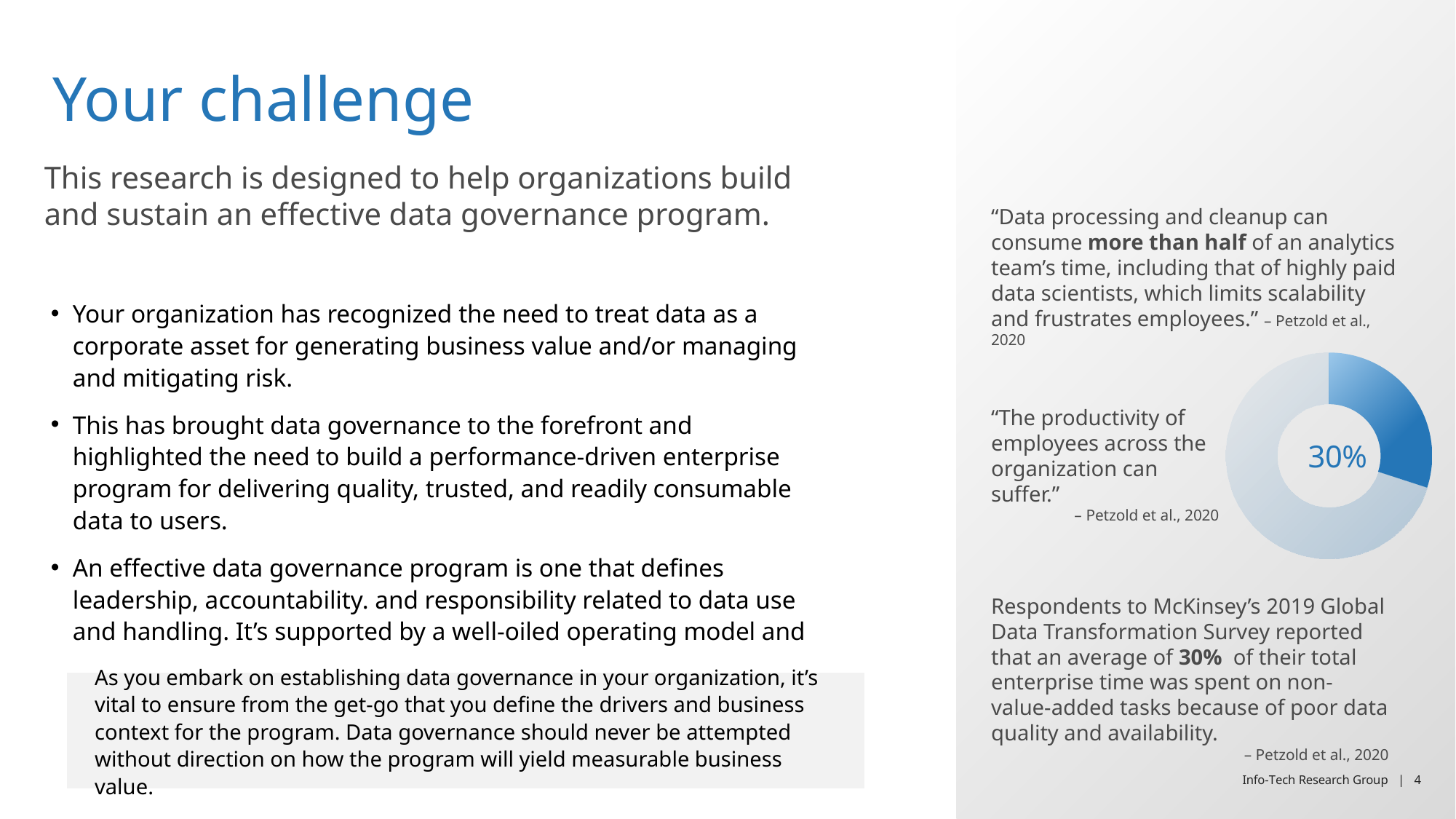
Does the donut chart include a legend? No How many slices does the donut chart have? 2 What colour is the highlighted 30% slice of the donut chart? dark blue What value is printed in the centre of the donut chart? 30% Which slice of the donut chart is larger, the dark blue one or the light blue one? light blue What share of the donut chart does the light blue slice represent? 70% What kind of chart is shown on the right side of the slide? donut chart What share of the donut chart does the dark blue slice represent? 30% Is the dark blue slice of the donut chart greater or less than 50% of the whole? less